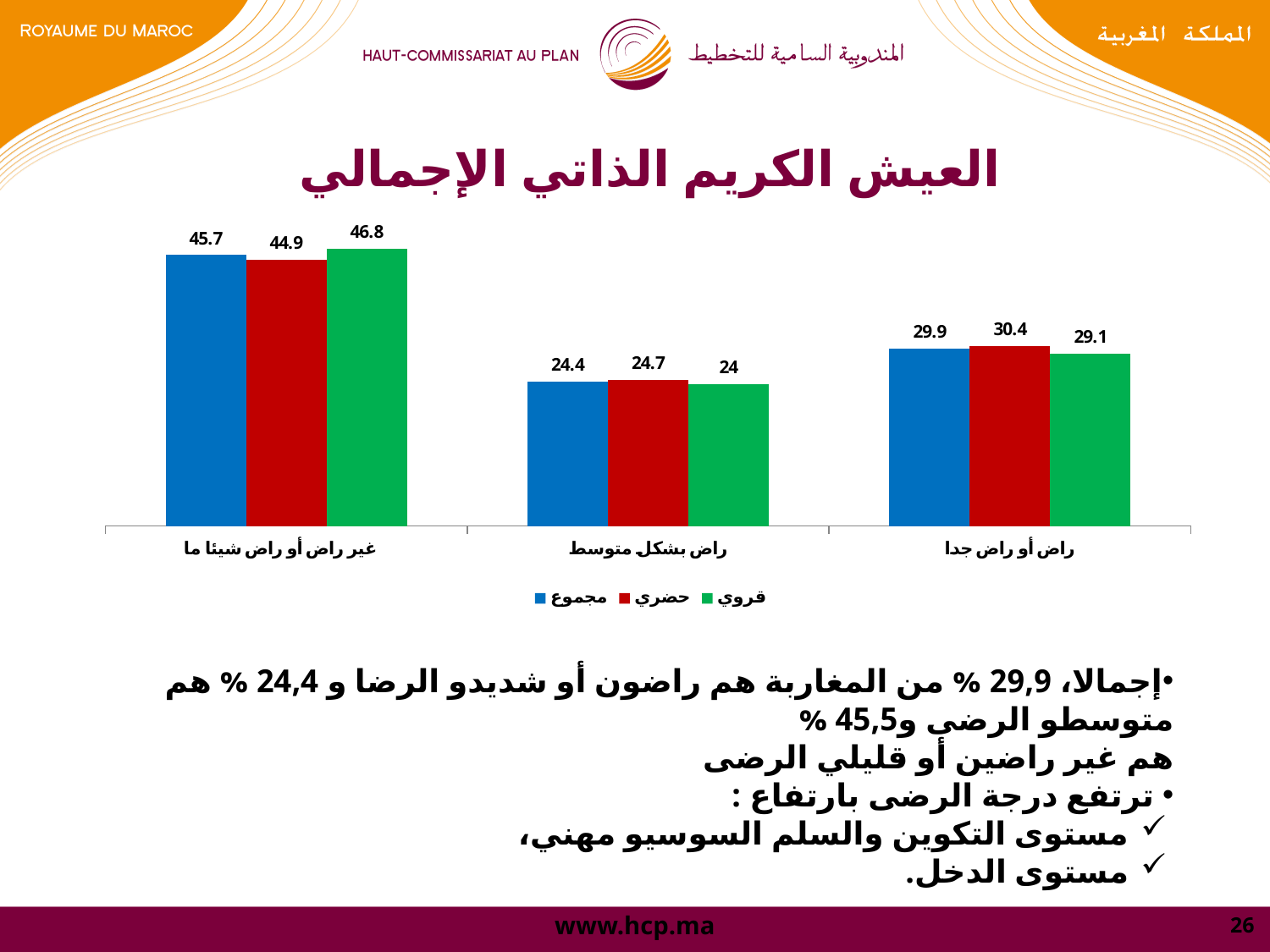
What is the title of the slide? العيش الكريم الذاتي الإجمالي What is the value for قروي in the category راض بشكل متوسط? 24 How many categories are shown on the x axis? 3 What kind of chart is shown on the slide? bar chart What is the value for مجموع in the category غير راض أو راض شيئا ما? 45.7 Which category has the lowest value for the حضري series? راض بشكل متوسط Which colour represents the قروي series in the legend? green In the category راض أو راض جدا, which is larger: the حضري value or the قروي value? حضري What is the difference between the قروي and حضري values in the category غير راض أو راض شيئا ما? 1.9 What is the value for حضري in the category راض أو راض جدا? 30.4 Which category has the highest value for the مجموع series? غير راض أو راض شيئا ما How many series does the legend list? 3